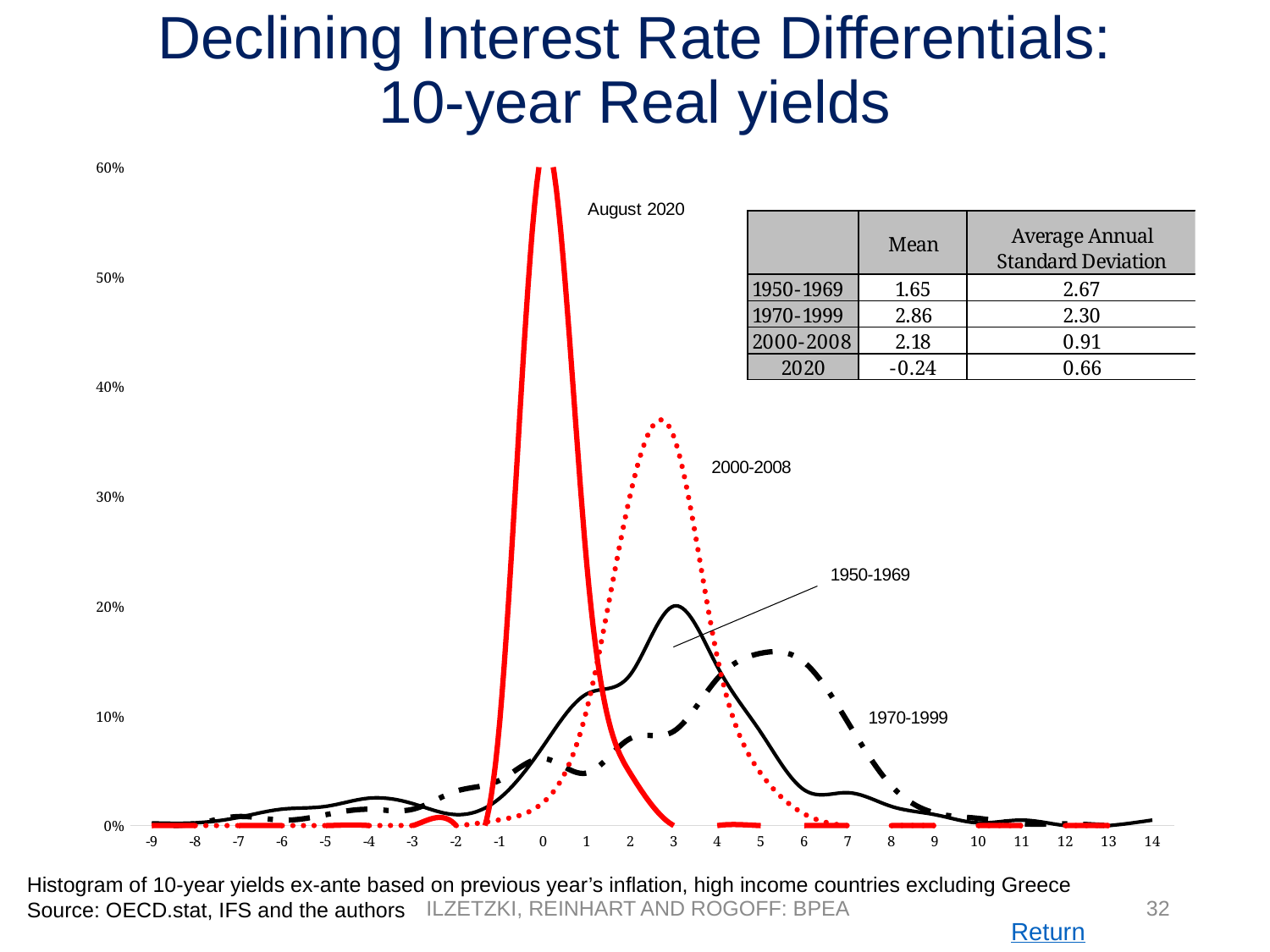
Is the peak of the 1970-1999 curve greater or less than 20%? less According to the table on the chart, what is the difference between the Average Annual Standard Deviation for 1950-1969 and for 2020? 2.01 Is the peak of the August 2020 curve greater or less than 50%? greater How many period curves are plotted on the chart? 4 According to the table on the chart, which period has the highest Mean? 1970-1999 Which period's curve has the lowest peak on the chart? 1970-1999 What kind of chart is shown on the slide? line chart Which period's curve reaches the highest peak on the chart? August 2020 Is the peak of the 2000-2008 curve greater or less than 30%? greater Which curve peaks higher, 2000-2008 or 1950-1969? 2000-2008 According to the table on the chart, what is the Mean for 2020? -0.24 According to the table on the chart, what is the Average Annual Standard Deviation for 2000-2008? 0.91